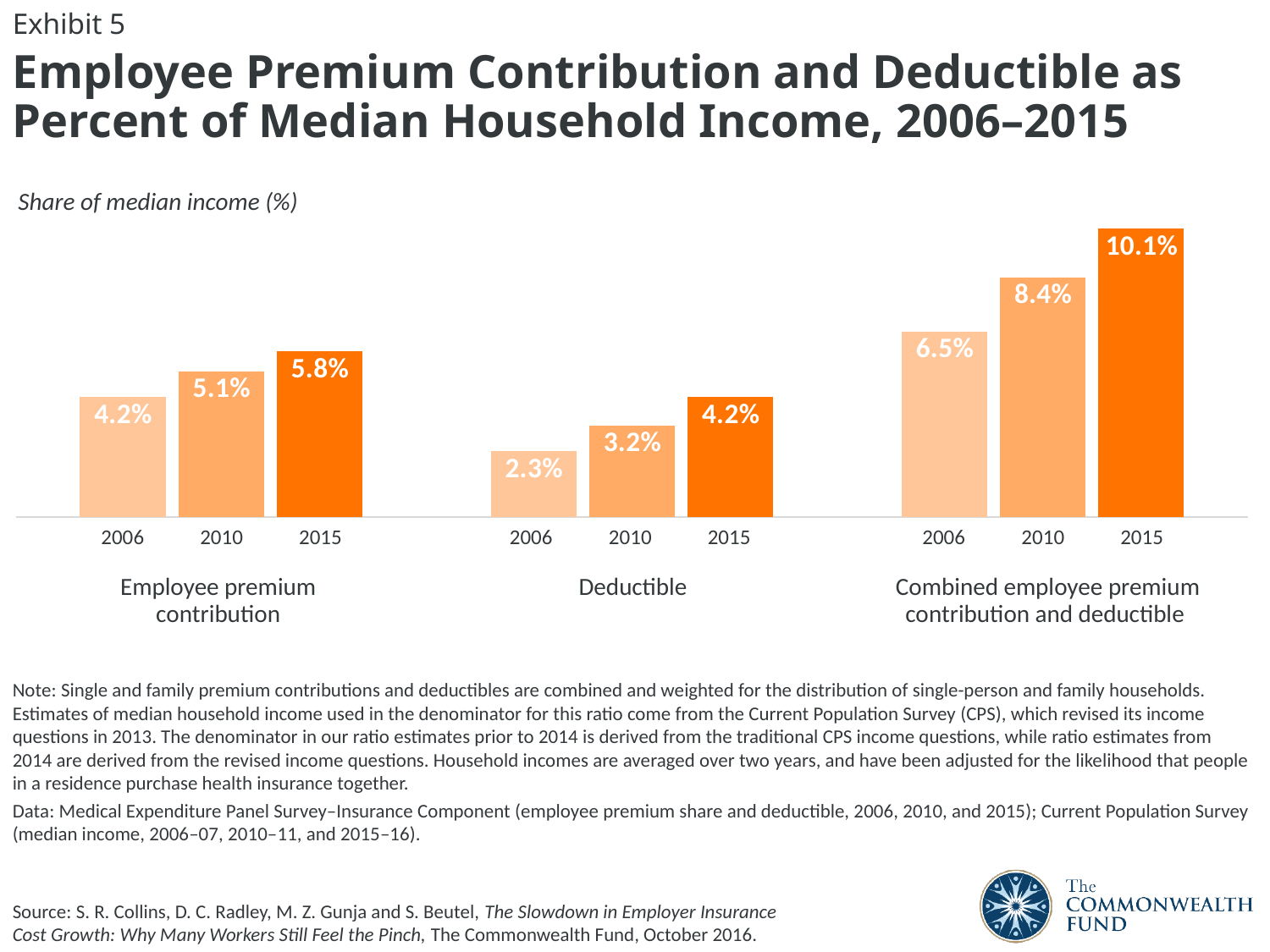
What is the difference between the employee premium contribution in 2015 and in 2010? 0.7 Which bar on the chart shows the highest value? Combined employee premium contribution and deductible, 2015 What kind of chart is shown on the slide? Bar chart By how many percentage points did the combined employee premium contribution and deductible rise from 2006 to 2015? 3.6 What was the employee premium contribution as a share of median income in 2006? 4.2% Which is larger: the employee premium contribution in 2010 or the deductible in 2015? Employee premium contribution in 2010 Which bar on the chart shows the lowest value? Deductible, 2006 Do the deductible values rise or fall from 2006 to 2015? Rise What was the deductible as a share of median income in 2015? 4.2% What unit is shown in the axis label above the chart? Share of median income (%) What was the combined employee premium contribution and deductible as a share of median income in 2010? 8.4% How many bars are plotted on the chart? 9